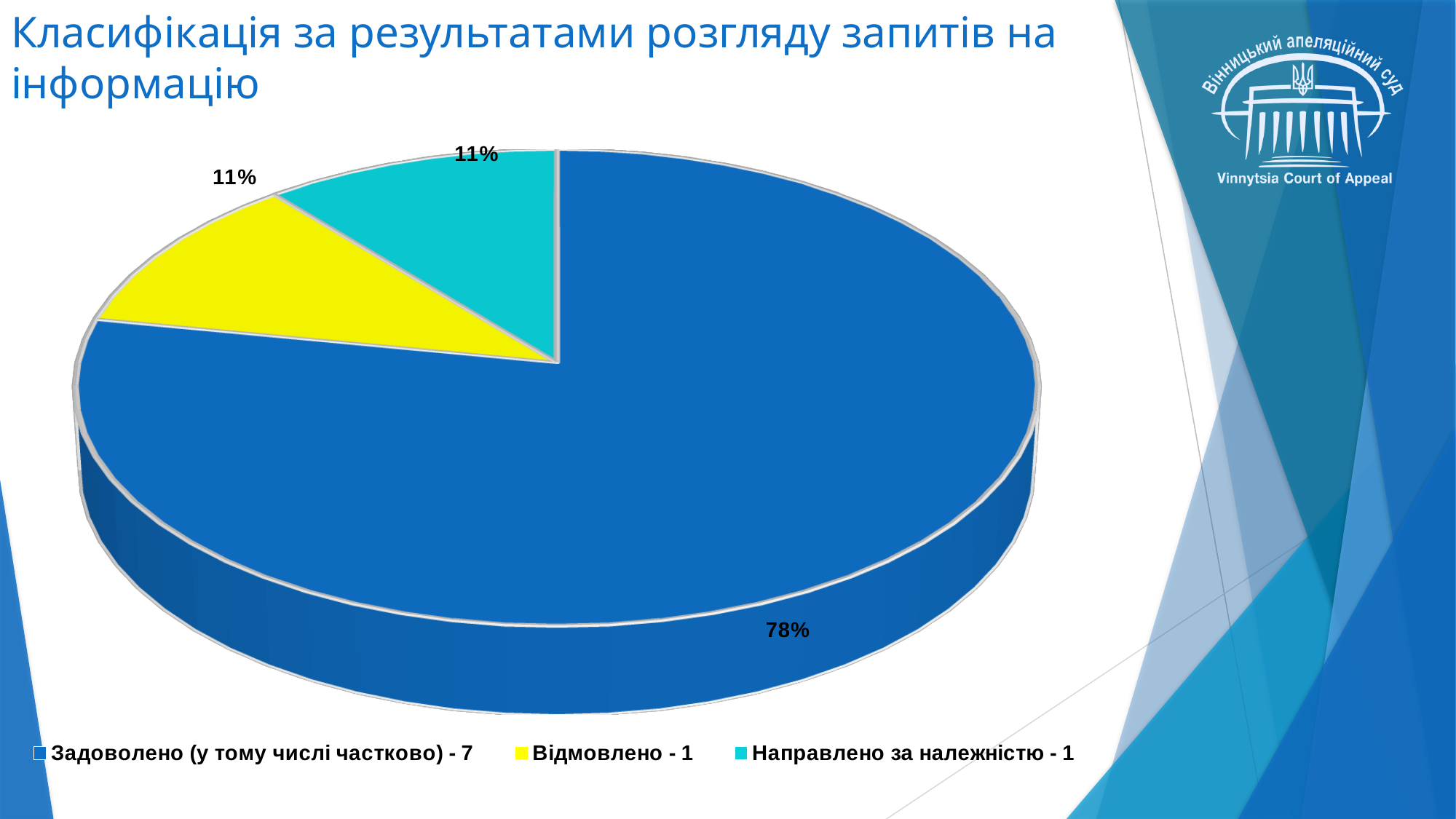
What is the title of the slide? Класифікація за результатами розгляду запитів на інформацію What colour is the "Відмовлено" slice? Yellow What share of the pie does "Направлено за належністю" take? 11% How many slices does the pie chart have? 3 According to the legend, how many requests were "Відмовлено"? 1 What share of the pie does "Відмовлено" take? 11% Which is larger: the share for "Задоволено (у тому числі частково)" or the share for "Відмовлено"? Задоволено (у тому числі частково) What share of the pie does "Задоволено (у тому числі частково)" take? 78% Which category has the largest slice of the pie? Задоволено (у тому числі частково) According to the legend, how many requests were "Задоволено (у тому числі частково)"? 7 What is the difference in percentage points between the "Задоволено (у тому числі частково)" slice and the "Відмовлено" slice? 67 What kind of chart is shown on the slide? Pie chart